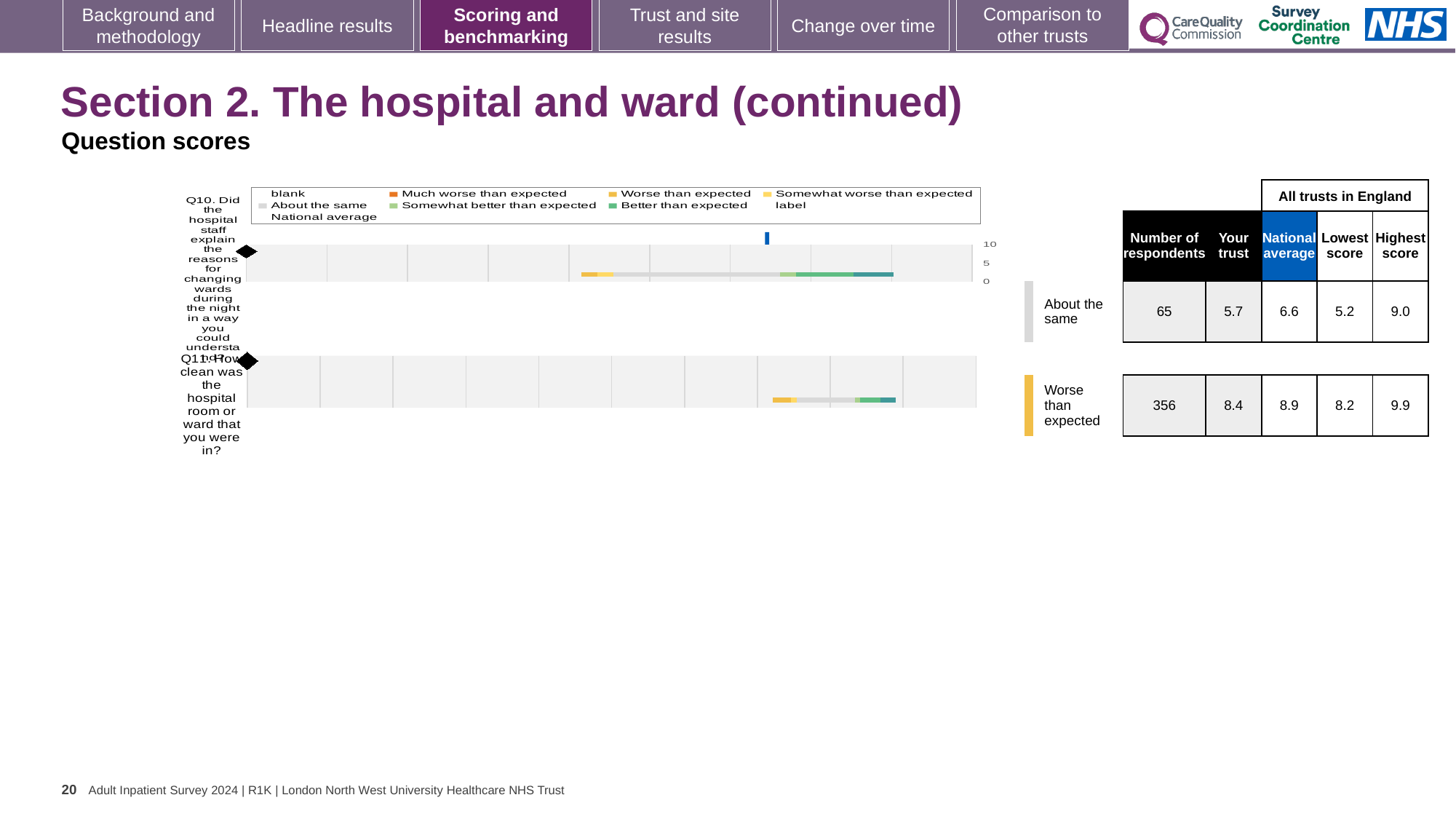
For Q11, which is larger: the 'Your trust' score or the national average? National average How many entries does the chart legend list? 9 What kind of chart is used to show the question scores for Q10 and Q11? Bar chart How many questions are plotted in the chart? 2 What is the highest score across all trusts in England for Q10? 9.0 Which question has the larger number of respondents, Q10 or Q11? Q11 Which legend entry is shown in grey? About the same Which benchmark category is Q11 assigned to? Worse than expected What is the difference between the highest score and the lowest score for Q11? 1.7 What is the national average for Q11? 8.9 What is the 'Your trust' score for Q10? 5.7 What is the number of respondents for Q10? 65